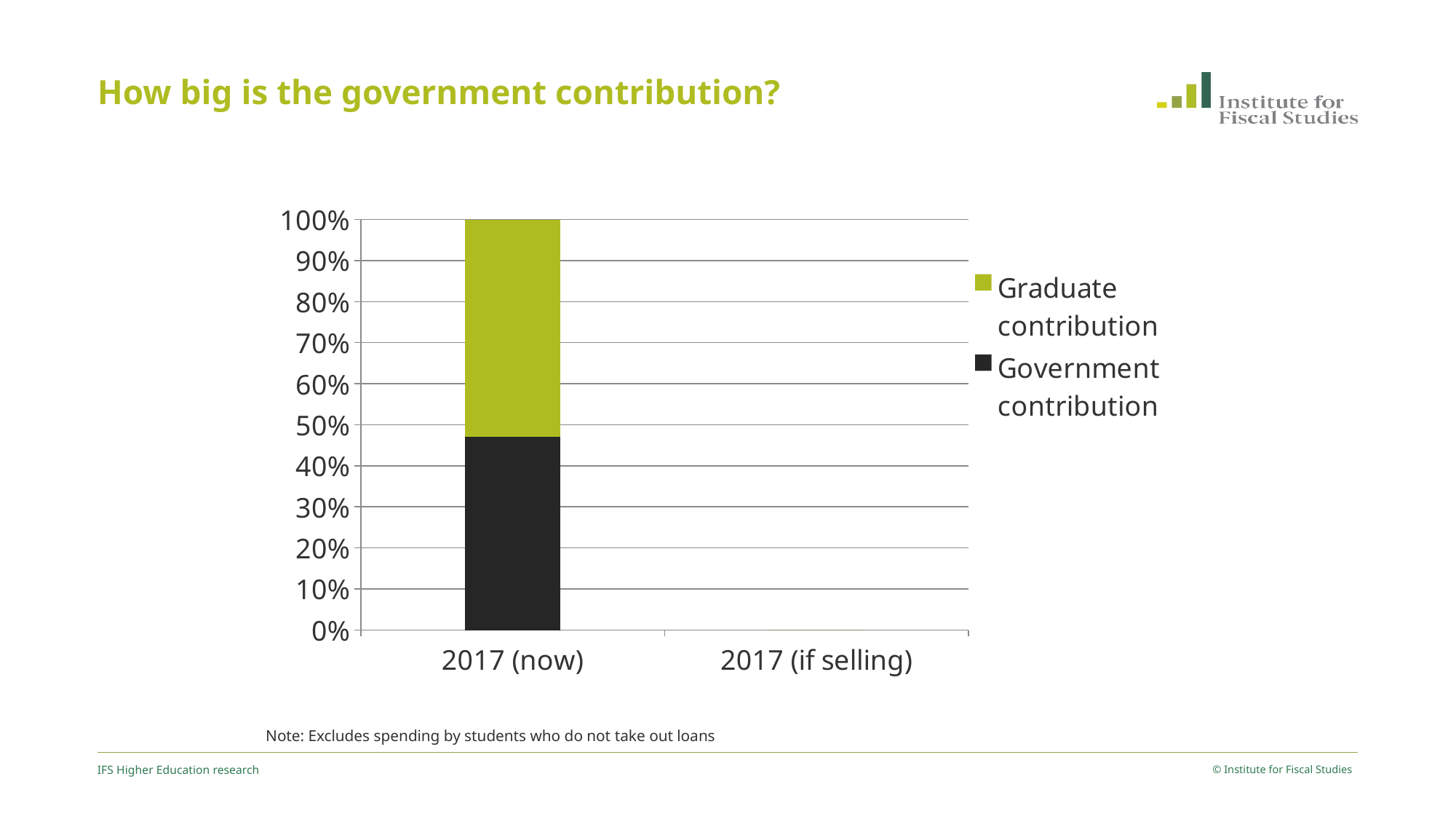
Is the government contribution for 2017 (now) greater or less than 50%? less What is the total height of the stacked bar for 2017 (now)? 100% How many categories are shown on the x axis? 2 Which category on the x axis has no bar plotted? 2017 (if selling) Is the government contribution for 2017 (now) greater or less than 40%? greater What kind of chart is shown on the slide? Stacked bar chart Is the graduate contribution for 2017 (now) greater or less than 50%? greater How many series does the legend list? 2 What is the highest value shown on the y axis? 100% What is the title of the slide? How big is the government contribution? For 2017 (now), which is larger: the graduate contribution or the government contribution? Graduate contribution